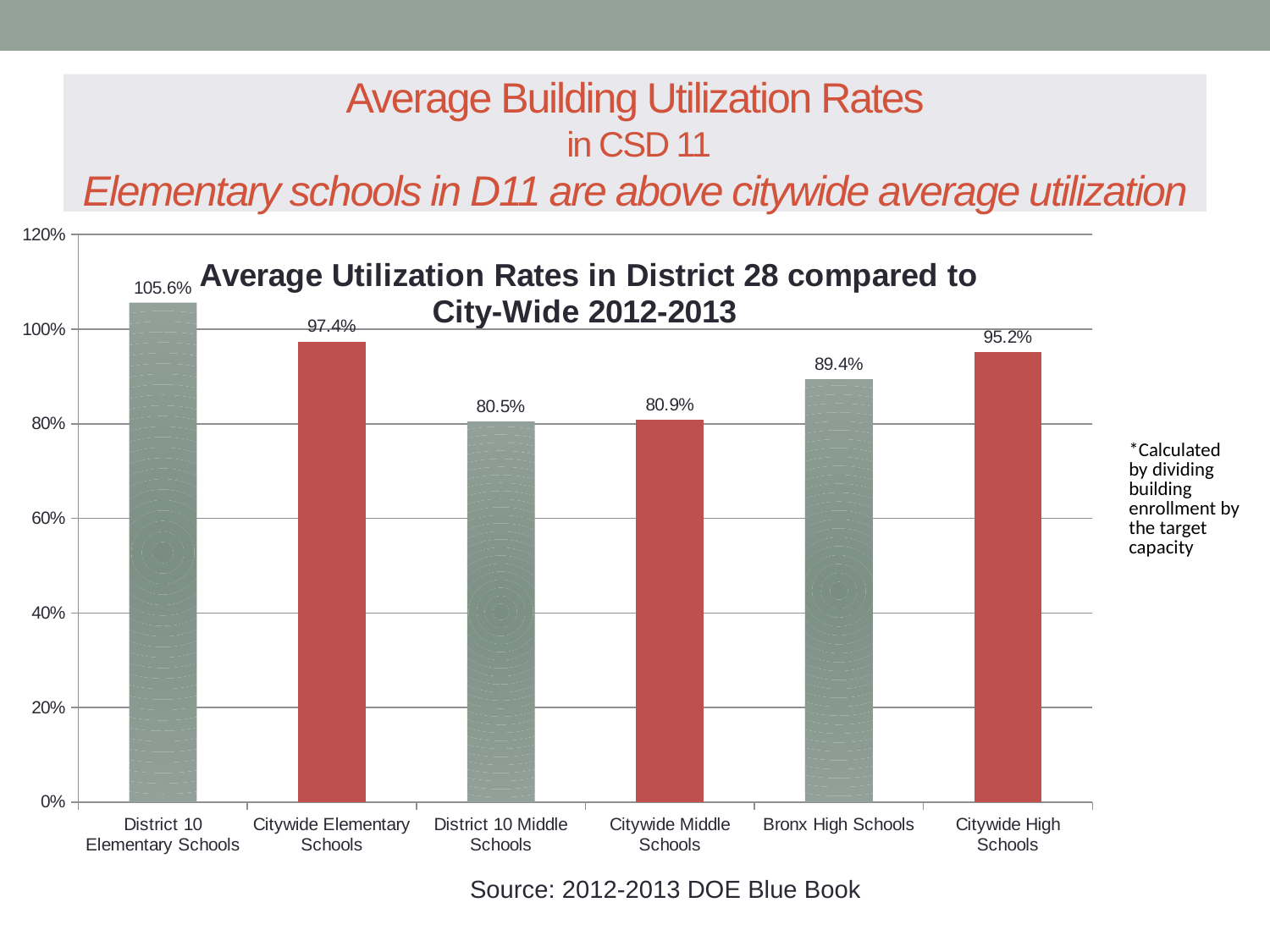
What is the average utilization rate for District 10 Elementary Schools? 105.6% Which category has the highest utilization rate? District 10 Elementary Schools What kind of chart is shown on the slide? Bar chart Is the value for District 10 Elementary Schools greater or less than 100%? greater What is the average utilization rate for Citywide Middle Schools? 80.9% Which is larger, the utilization rate for Bronx High Schools or for Citywide High Schools? Citywide High Schools Which category has the lowest utilization rate? District 10 Middle Schools What is the difference between the utilization rates of District 10 Elementary Schools and Citywide Elementary Schools? 8.2% What is the average utilization rate for Bronx High Schools? 89.4% How many categories are shown on the chart? 6 What is the title printed inside the chart area? Average Utilization Rates in District 28 compared to City-Wide 2012-2013 What is the difference between the utilization rates of Citywide High Schools and Bronx High Schools? 5.8%